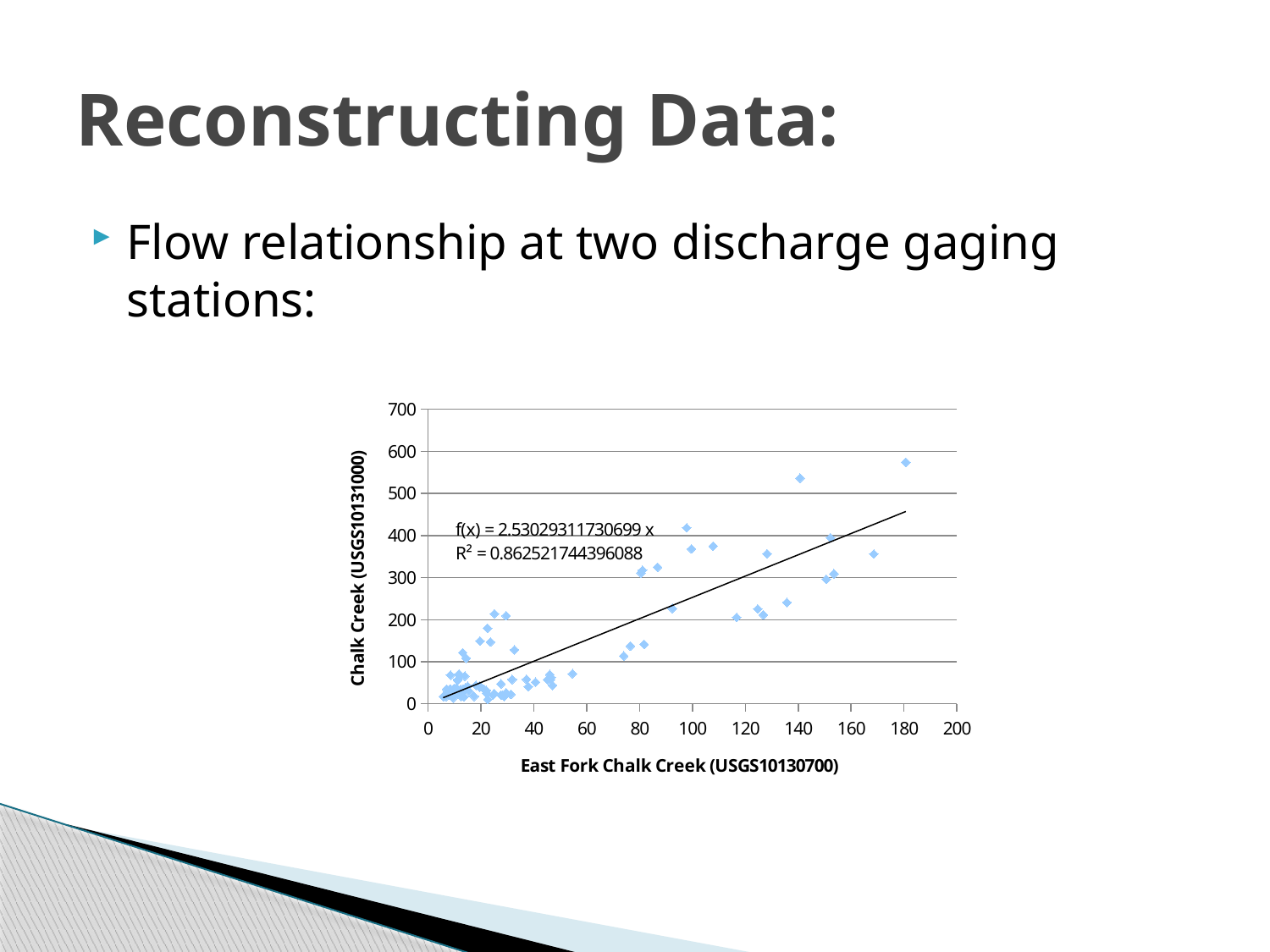
Is the East Fork Chalk Creek value of the rightmost plotted point greater or less than 160? greater What is the label of the x axis of the chart? East Fork Chalk Creek (USGS10130700) What is the slope of the fitted trendline shown on the chart? 2.53029311730699 What is the maximum value shown on the y axis? 700 What is the label of the y axis of the chart? Chalk Creek (USGS10131000) What kind of chart is shown on the slide? Scatter chart Do the Chalk Creek values generally rise or fall as the East Fork Chalk Creek values increase along the x axis? Rise What R² value is printed on the chart? 0.862521744396088 Is the Chalk Creek value of the highest plotted point greater or less than 500? greater What is the trendline equation printed on the chart? f(x) = 2.53029311730699 x Is the R² value of the trendline greater or less than 0.8? greater